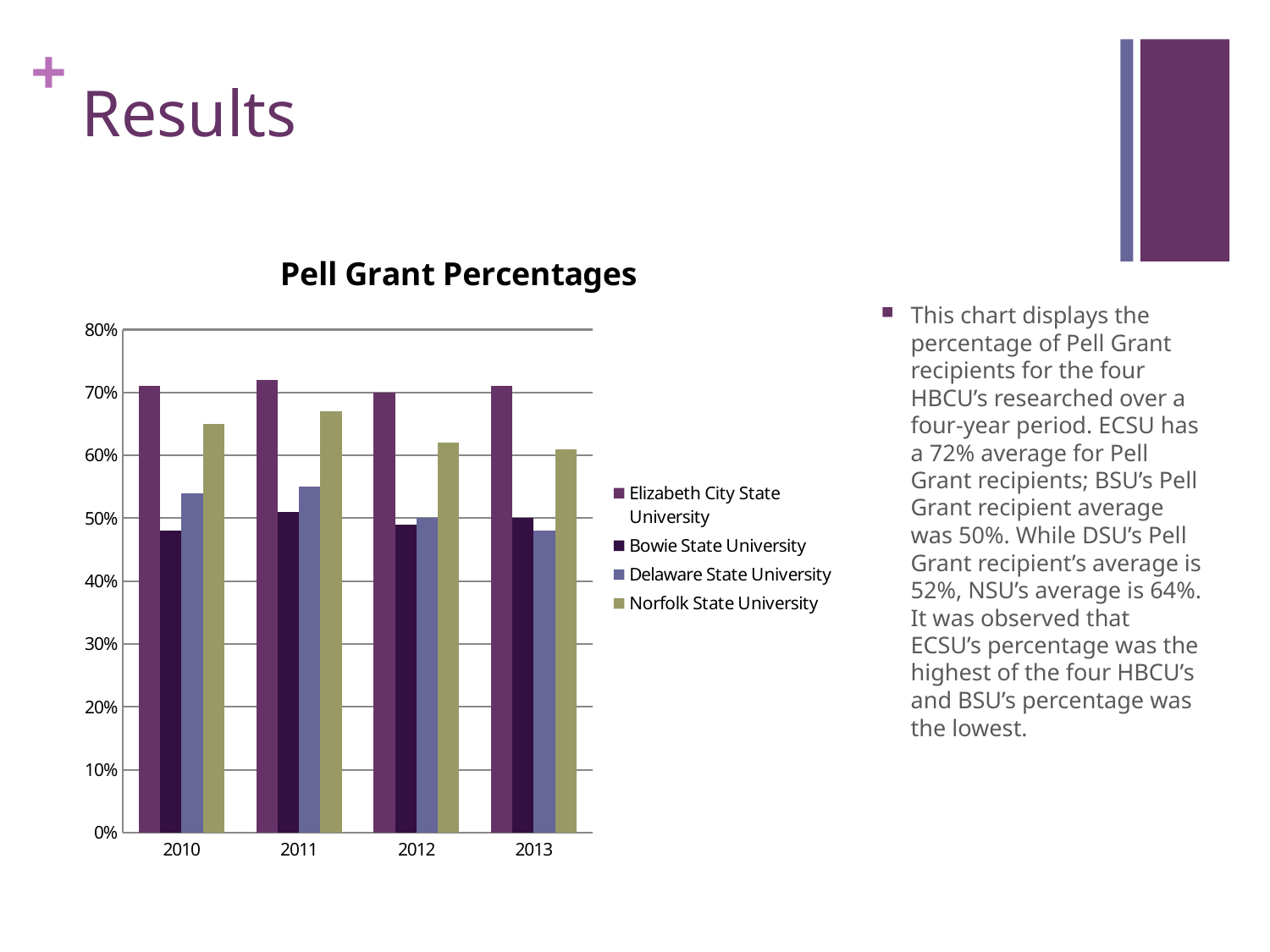
What is the title of the chart? Pell Grant Percentages How many years are shown on the x axis? 4 Is the value for Delaware State University in 2011 greater or less than 50%? greater How many series does the legend list? 4 Does the value for Norfolk State University rise or fall from 2011 to 2013? fall In 2012, which is larger: the value for Norfolk State University or Delaware State University? Norfolk State University Which university has the lowest Pell Grant percentage in 2011? Bowie State University Which university has the highest Pell Grant percentage in 2010? Elizabeth City State University Which university has the lowest Pell Grant percentage in 2010? Bowie State University Is the value for Norfolk State University in 2011 greater or less than 60%? greater What kind of chart is shown on the slide? bar chart Is the value for Elizabeth City State University in 2010 greater or less than 60%? greater